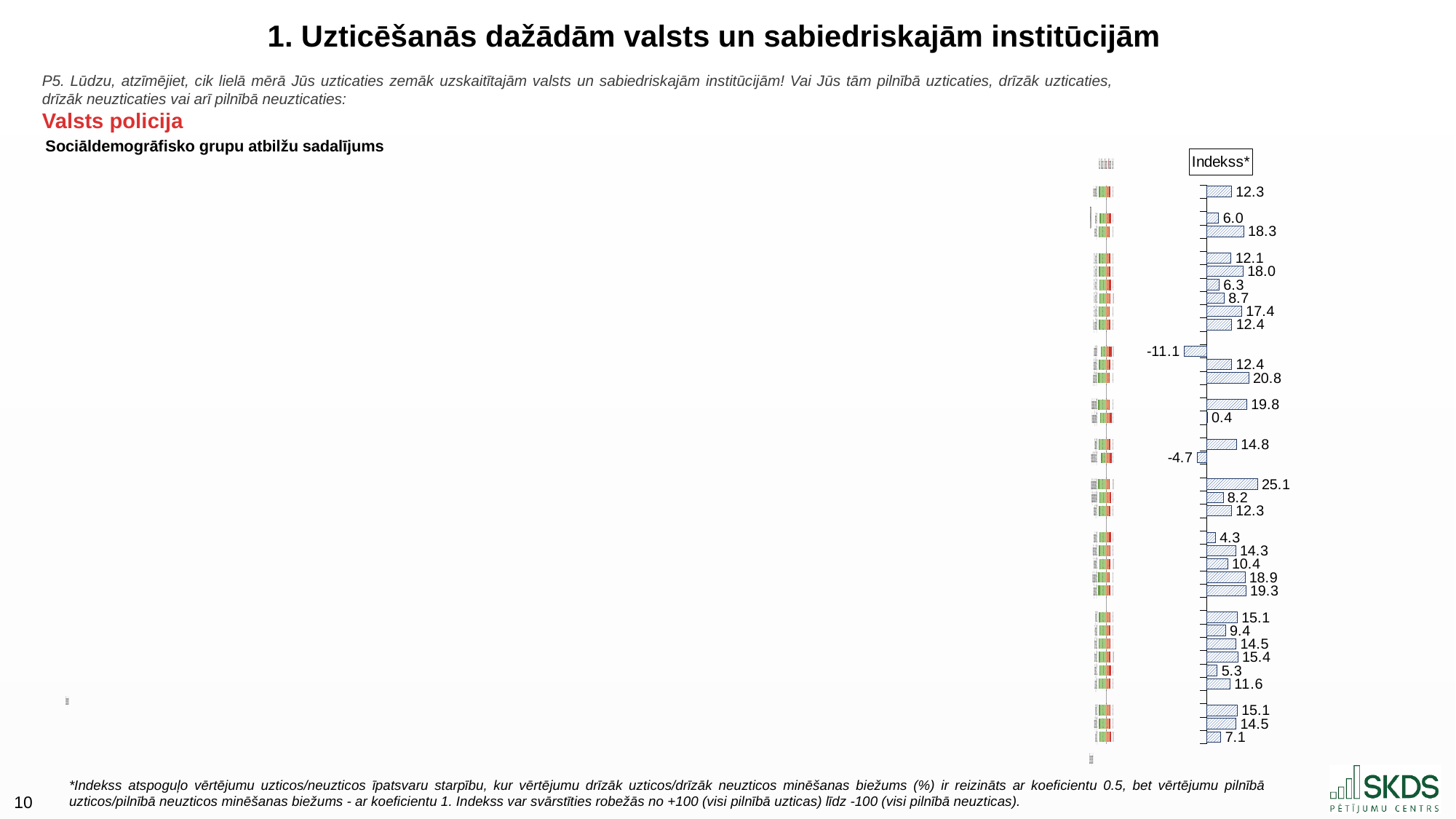
In the Indekss* chart, what is the highest index value shown? 25.1 What is the value of the topmost bar in the Indekss* chart? 12.3 What is the value of the bottommost bar in the Indekss* chart? 7.1 How many bars in the Indekss* chart have a negative value? 2 What is the title shown above the index chart on the right? Indekss* In the Indekss* chart, what is the difference between the topmost bar (12.3) and the bottommost bar (7.1)? 5.2 How many bars are plotted in the Indekss* chart? 33 What kind of chart is the Indekss* chart on the right side of the slide? bar chart Which institution is the slide's chart about, according to the red heading? Valsts policija In the Indekss* chart, what is the lowest index value shown? -11.1 In the Indekss* chart, what is the difference between the highest value (25.1) and the lowest value (-11.1)? 36.2 In the Indekss* chart, which is larger: the topmost bar (12.3) or the bottommost bar (7.1)? the topmost bar (12.3)